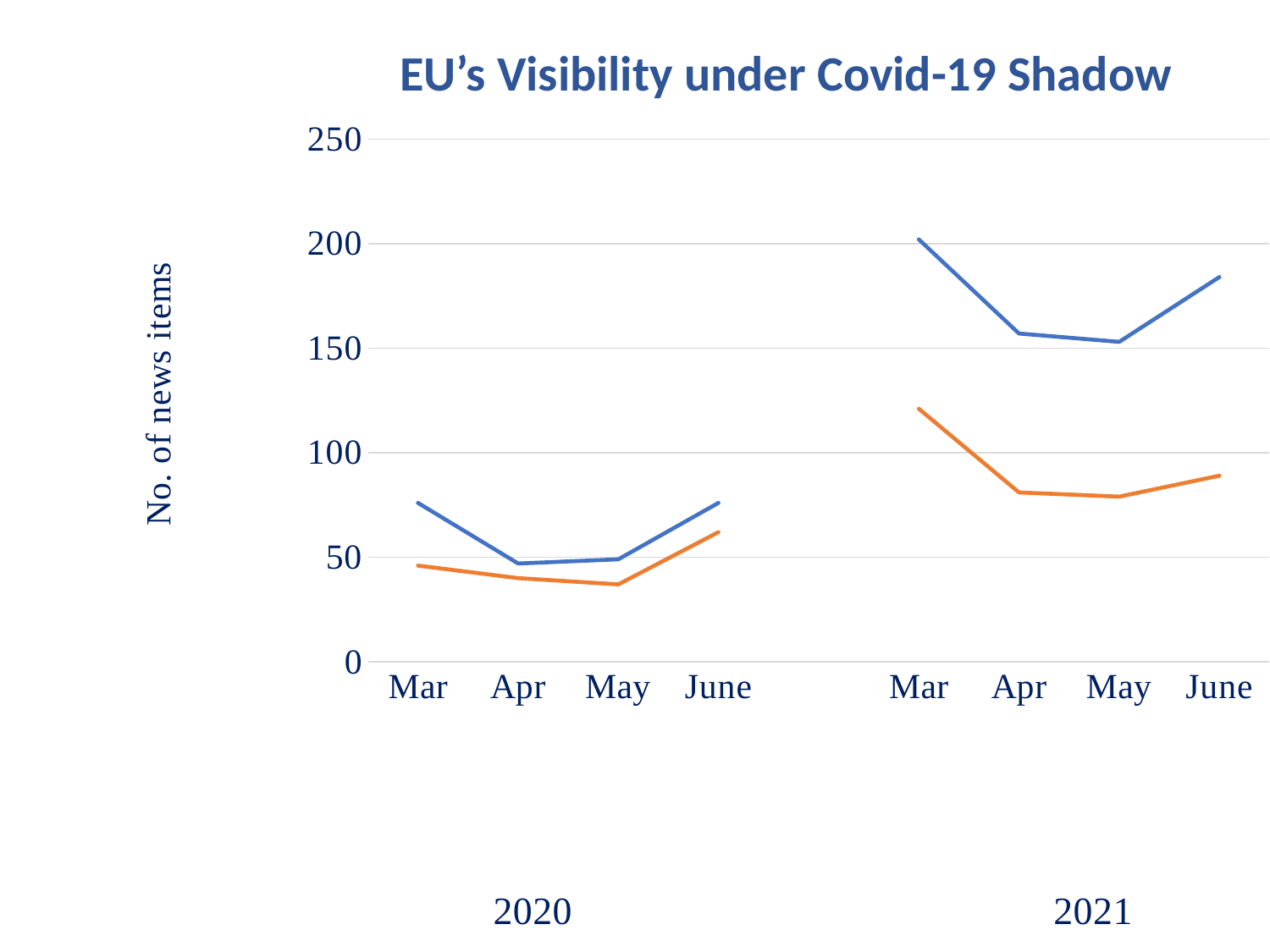
What is the label on the vertical axis of the chart? No. of news items In 2021, which month has the highest value on the blue line? Mar Is the value of the orange line for Mar 2021 greater or less than 100? greater How many lines are plotted on the chart? 2 Is the value of the orange line for May 2020 greater or less than 50? less Does the orange line rise or fall from May to June 2021? rise What is the title of the chart? EU's Visibility under Covid-19 Shadow Is the value of the blue line for Mar 2021 greater or less than 150? greater Which is larger for the blue line: the value for Mar 2020 or the value for Mar 2021? Mar 2021 How many month categories are shown along the x axis in total? 8 What kind of chart is shown on the slide? line chart